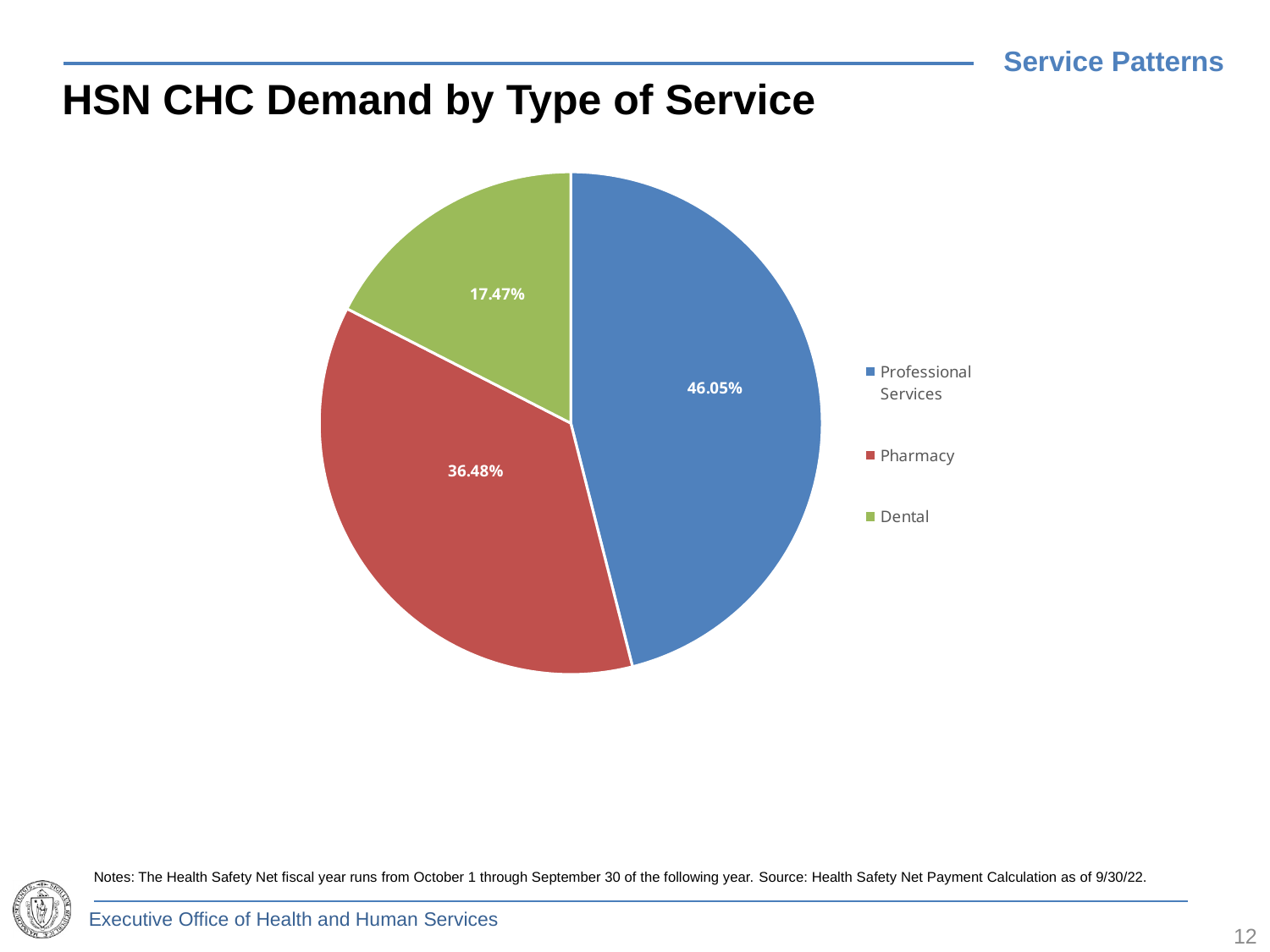
Which type of service has the largest share of HSN CHC demand? Professional Services Which type of service has the smallest share of HSN CHC demand? Dental What is the difference in percentage points between the Professional Services share and the Pharmacy share? 9.57 What share of HSN CHC demand is Dental? 17.47% What share of HSN CHC demand is Pharmacy? 36.48% How many entries does the legend list? 3 Which has a larger share of HSN CHC demand, Pharmacy or Dental? Pharmacy What colour is the Dental slice in the pie chart? Green How many slices does the pie chart have? 3 What type of chart is shown on the slide? Pie chart What share of HSN CHC demand is Professional Services? 46.05% What is the title of the chart on the slide? HSN CHC Demand by Type of Service